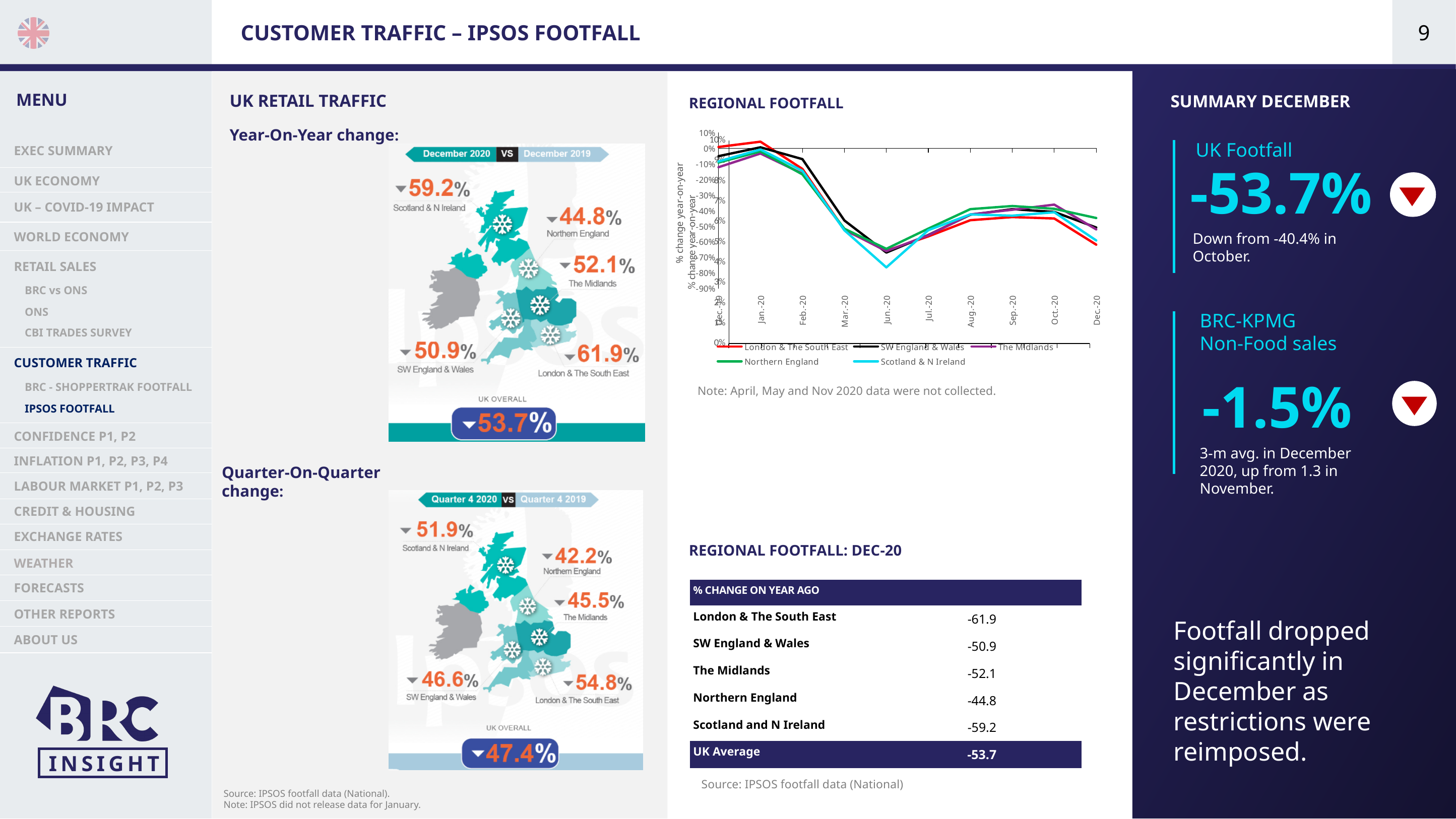
How many month labels are shown on the x axis of the Regional Footfall chart? 10 How many series does the legend of the Regional Footfall chart list? 5 In the Regional Footfall chart, do the values rise or fall between Feb-20 and Jun-20? fall In the Regional Footfall chart, which series has the highest value at Jan-20? London & The South East In the Regional Footfall: Dec-20 table, which region has the lowest % change on year ago? London & The South East In the Regional Footfall chart, which is higher at Oct-20: The Midlands or London & The South East? The Midlands In the Regional Footfall chart, which series has the lowest value at Jun-20? Scotland & N Ireland Which series are listed in the legend of the Regional Footfall chart? London & The South East, SW England & Wales, The Midlands, Northern England, Scotland & N Ireland What kind of chart is the Regional Footfall chart? line chart In the Regional Footfall: Dec-20 table, what is the % change on year ago for Northern England? -44.8 In the Regional Footfall chart, is the value for Scotland & N Ireland at Jun-20 greater or less than -70%? less In the Regional Footfall: Dec-20 table, what is the difference between the values for London & The South East (-61.9) and Northern England (-44.8)? 17.1